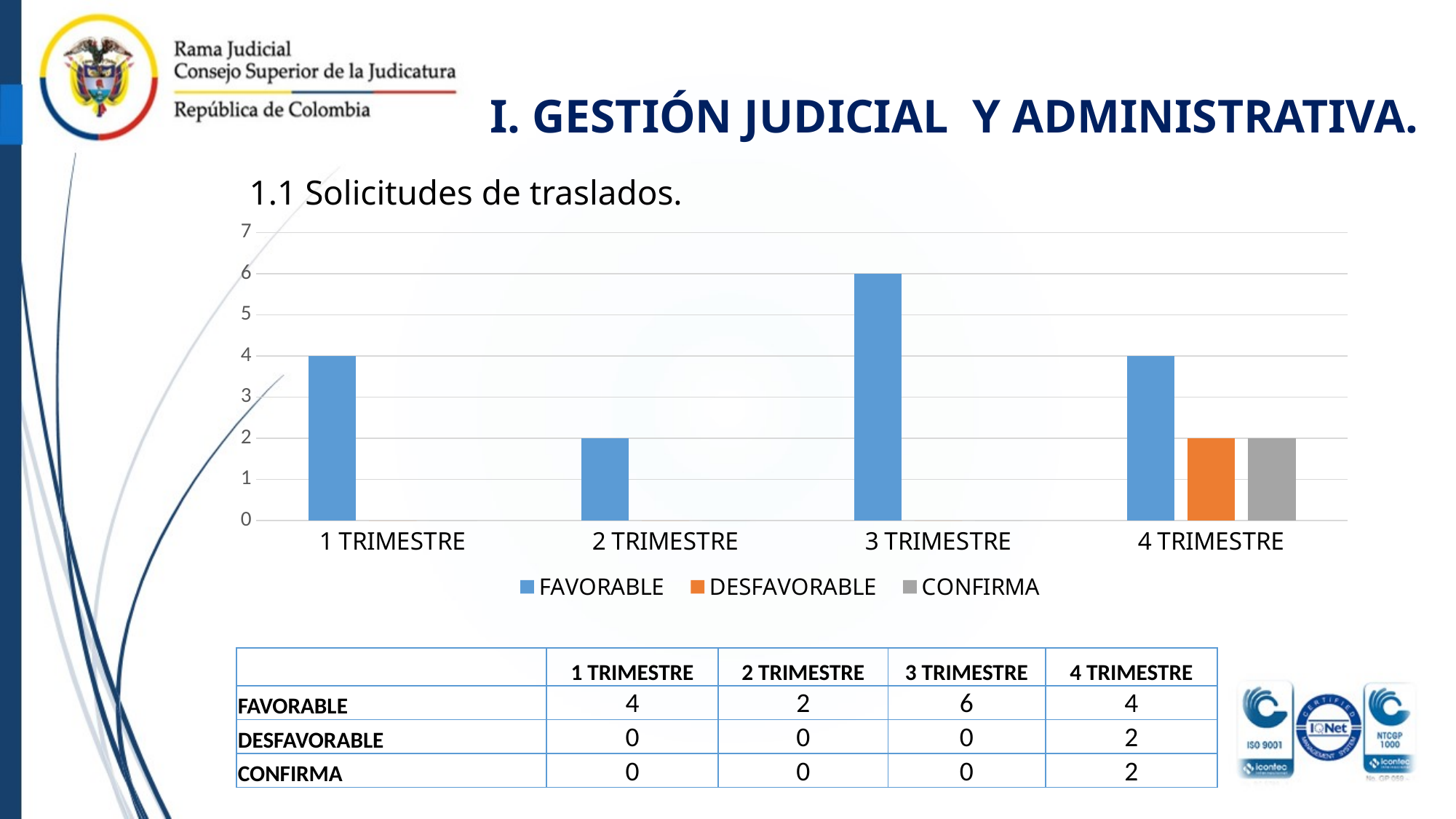
Which is larger, the FAVORABLE value for 1 TRIMESTRE or for 2 TRIMESTRE? 1 TRIMESTRE What is the difference between the FAVORABLE values for 3 TRIMESTRE and 2 TRIMESTRE? 4 What is the FAVORABLE value for 3 TRIMESTRE? 6 Which trimester has the highest FAVORABLE value? 3 TRIMESTRE How many series does the legend list? 3 What kind of chart is shown on the slide? bar chart How many trimester categories are shown on the x axis? 4 Is the FAVORABLE value for 3 TRIMESTRE greater or less than 5? greater What is the FAVORABLE value for 2 TRIMESTRE? 2 What colour represents the DESFAVORABLE series in the chart? orange What is the DESFAVORABLE value for 4 TRIMESTRE? 2 Which trimester has the lowest FAVORABLE value? 2 TRIMESTRE